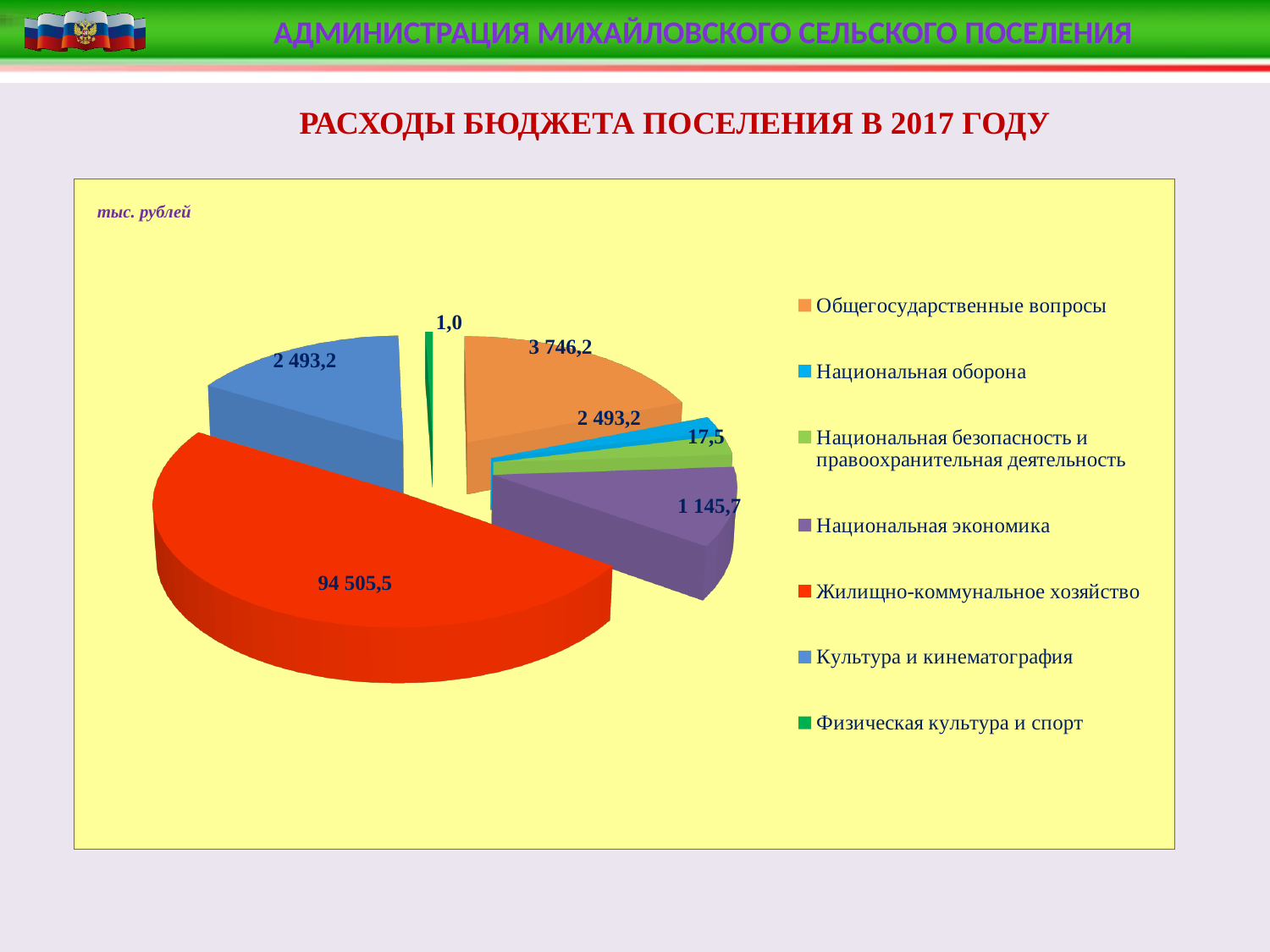
What is the value for Физическая культура и спорт? 1,0 What is the value for Общегосударственные вопросы? 3 746,2 What is the value for Национальная безопасность и правоохранительная деятельность? 17,5 What is the value for Жилищно-коммунальное хозяйство? 94 505,5 What is the difference between the values for Общегосударственные вопросы and Национальная экономика? 2 600,5 What kind of chart is shown on the slide? Pie chart Which category has the largest slice of the pie? Жилищно-коммунальное хозяйство What is the value for Национальная экономика? 1 145,7 Which is larger: Общегосударственные вопросы or Национальная экономика? Общегосударственные вопросы How many categories does the legend of the pie chart list? 7 Which category has the smallest value in the pie chart? Физическая культура и спорт In what units are the values of the chart given, according to the label in the top-left corner of the chart area? тыс. рублей